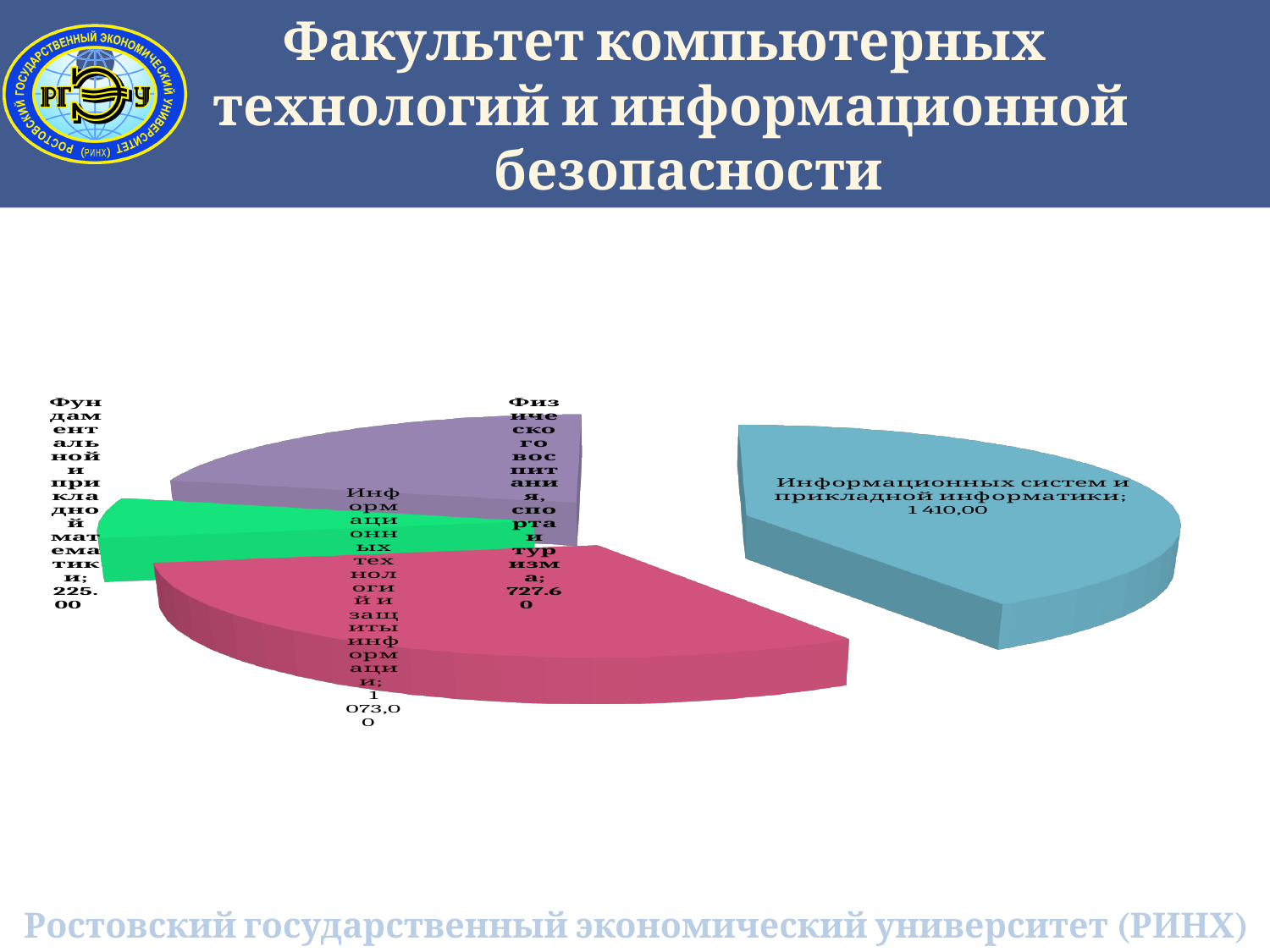
What kind of chart is shown on the slide? Pie chart What is the value for Фундаментальной и прикладной математики? 225.00 What is the value for Физического воспитания, спорта и туризма? 727.60 What is the value for Информационных систем и прикладной информатики? 1 410,00 What is the value for Информационных технологий и защиты информации? 1 073,00 What is the difference between the values for Физического воспитания, спорта и туризма and Фундаментальной и прикладной математики? 502.60 What is the difference between the values for Информационных систем и прикладной информатики and Информационных технологий и защиты информации? 337,00 Which category has the largest slice of the pie? Информационных систем и прикладной информатики Which is larger: the value for Информационных технологий и защиты информации or the value for Физического воспитания, спорта и туризма? Информационных технологий и защиты информации What colour is the slice for Информационных систем и прикладной информатики? Blue How many slices does the pie chart have? 4 Which category has the smallest slice of the pie? Фундаментальной и прикладной математики